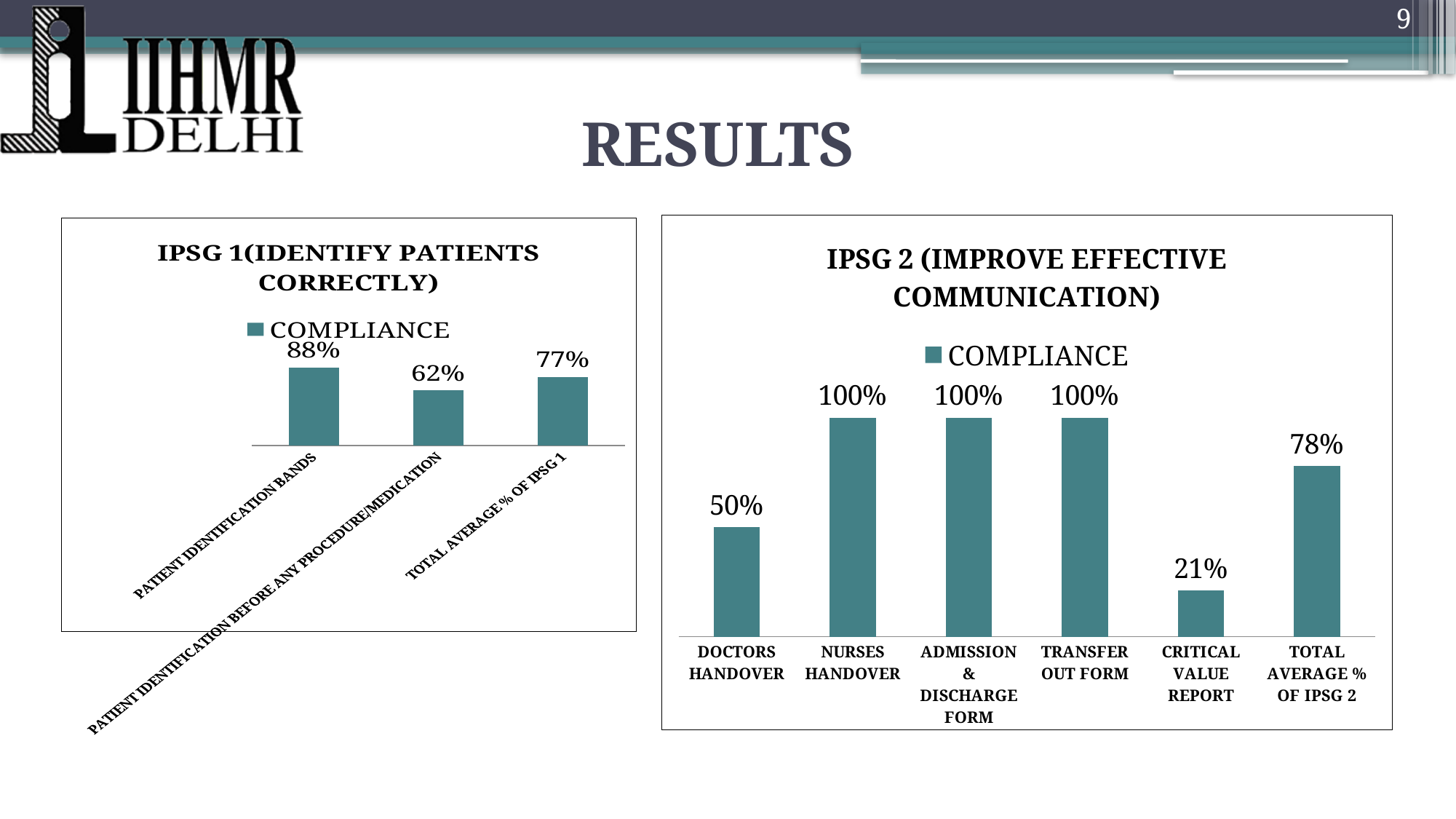
In the IPSG 1 (Identify Patients Correctly) chart, which category has the lowest compliance? Patient Identification Before Any Procedure/Medication In the IPSG 1 (Identify Patients Correctly) chart, what is the compliance value for Patient Identification Before Any Procedure/Medication? 62% In the IPSG 2 (Improve Effective Communication) chart, how many categories are plotted? 6 In the IPSG 1 (Identify Patients Correctly) chart, what is the Total Average % of IPSG 1? 77% What type of chart is the IPSG 2 (Improve Effective Communication) chart? Bar chart In the IPSG 2 (Improve Effective Communication) chart, which is larger: the compliance for Doctors Handover or for Nurses Handover? Nurses Handover In the IPSG 2 (Improve Effective Communication) chart, what is the compliance value for Critical Value Report? 21% In the IPSG 2 (Improve Effective Communication) chart, which category has the lowest compliance? Critical Value Report In the IPSG 2 (Improve Effective Communication) chart, what is the compliance value for Doctors Handover? 50% In the IPSG 1 (Identify Patients Correctly) chart, what is the difference between the compliance for Patient Identification Bands and Patient Identification Before Any Procedure/Medication? 26% In the IPSG 1 (Identify Patients Correctly) chart, what is the compliance value for Patient Identification Bands? 88% In the IPSG 2 (Improve Effective Communication) chart, what is the Total Average % of IPSG 2? 78%